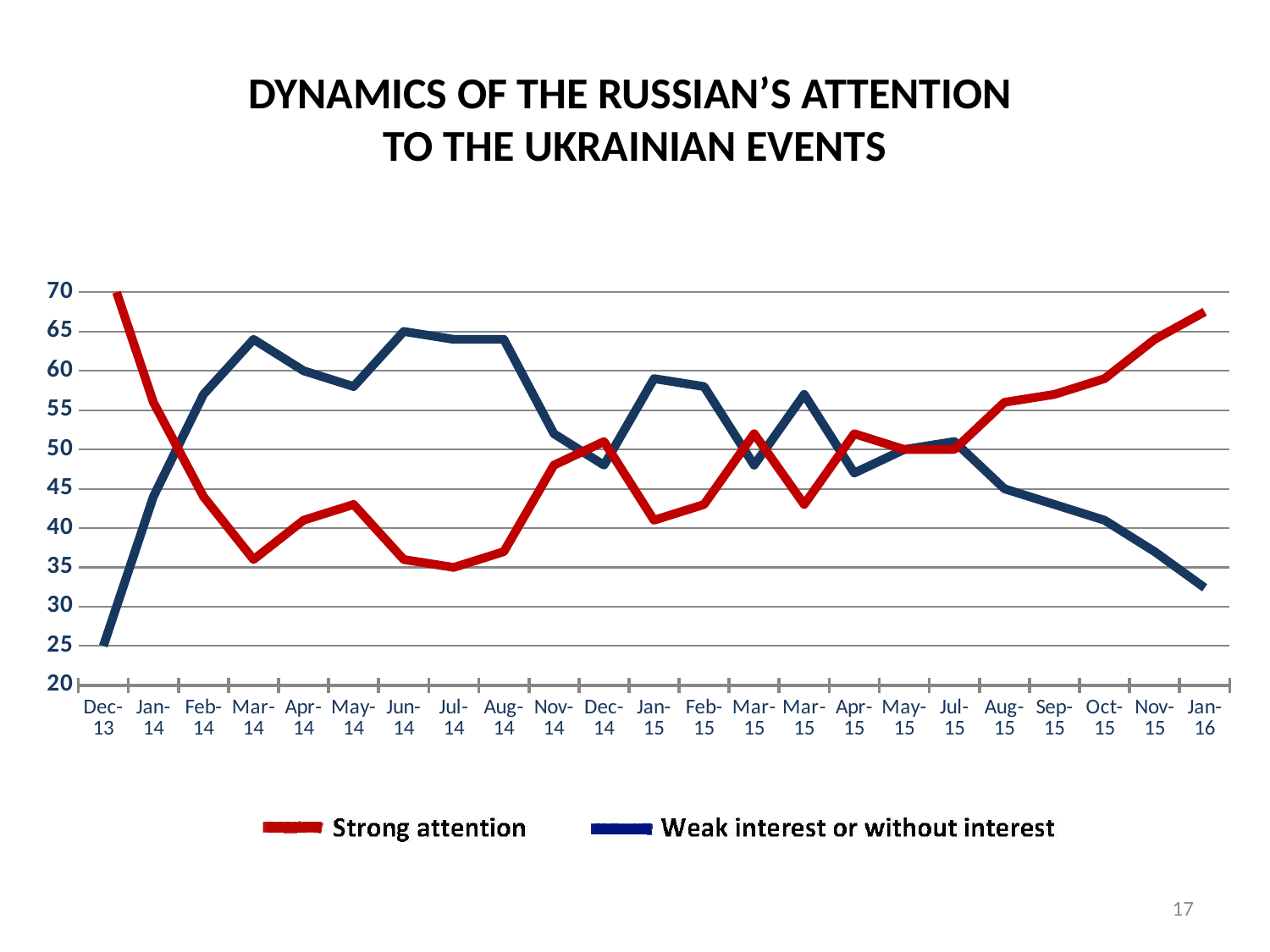
How many series does the legend list? 2 How many time points are plotted along the x axis? 23 Does the Weak interest or without interest series rise or fall from Jul-15 to Jan-16? fall Is the value for Strong attention at Jan-16 greater or less than 65? greater Is the value for Weak interest or without interest at Dec-13 greater or less than 30? less Is the value for Weak interest or without interest at Jan-16 greater or less than 35? less At which time point is the Weak interest or without interest series lowest? Dec-13 Which series is drawn in red? Strong attention At which time point is the Strong attention series highest? Dec-13 At Mar-14, which series has the larger value, Strong attention or Weak interest or without interest? Weak interest or without interest What kind of chart is shown on the slide? line chart